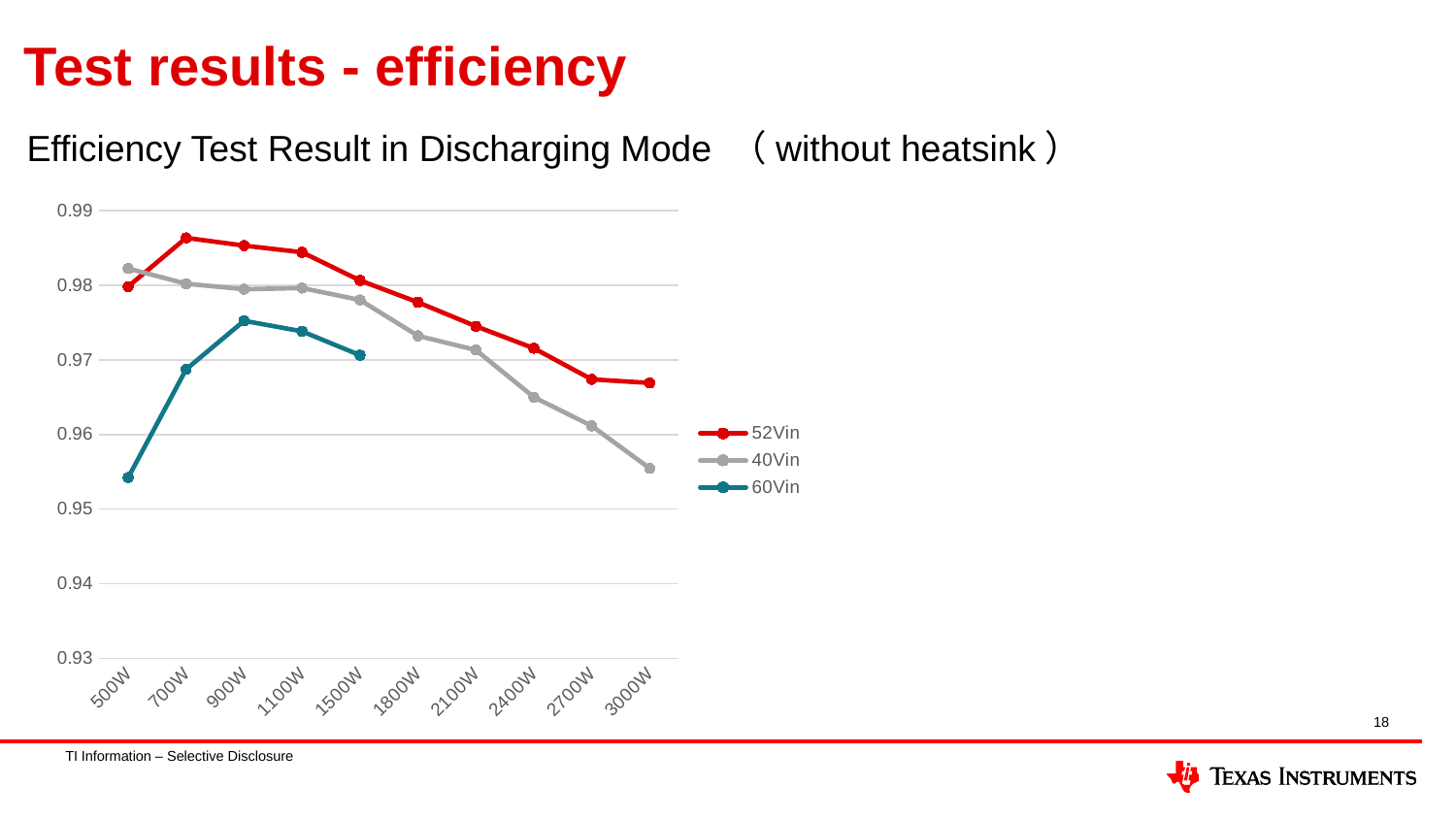
Does the 40Vin series rise or fall as power increases from 500W to 3000W? fall Is the value for 52Vin at 3000W greater or less than 0.97? less Is the value for 40Vin at 3000W greater or less than 0.96? less What kind of chart is shown on the slide? line chart At 1500W, which series has the higher efficiency, 52Vin or 60Vin? 52Vin How many power levels are shown on the x axis? 10 At 500W, which series has the higher efficiency, 40Vin or 60Vin? 40Vin Is the value for 60Vin at 500W greater or less than 0.96? less How many series does the legend list? 3 What are the three series named in the legend? 52Vin, 40Vin, 60Vin Which series is drawn in red? 52Vin